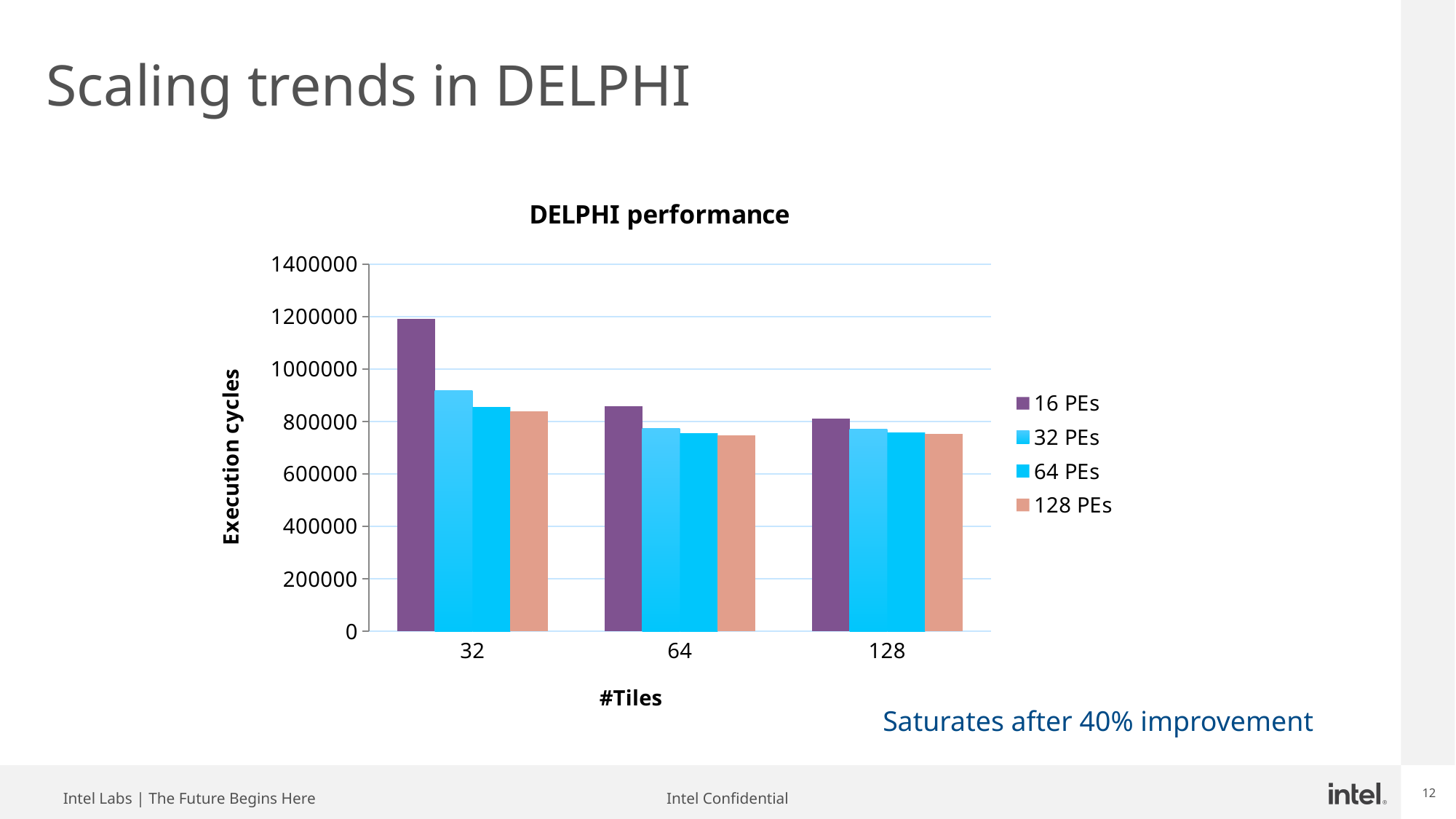
Is the value for 16 PEs at 32 tiles greater or less than 1000000? greater Do the execution cycles for 16 PEs rise or fall as the number of tiles increases? fall Is the value for 32 PEs at 32 tiles greater or less than 1000000? less Which series has the highest execution cycles at 32 tiles? 16 PEs Is the value for 128 PEs at 64 tiles greater or less than 800000? less What kind of chart is shown on the slide? bar chart How many #Tiles categories are shown on the x axis of the chart? 3 Which combination of tiles and PEs has the highest execution cycles in the chart? 16 PEs at 32 tiles What is the label of the y axis of the chart? Execution cycles Which is larger: the value for 16 PEs at 32 tiles or the value for 16 PEs at 64 tiles? 16 PEs at 32 tiles How many series does the legend of the DELPHI performance chart list? 4